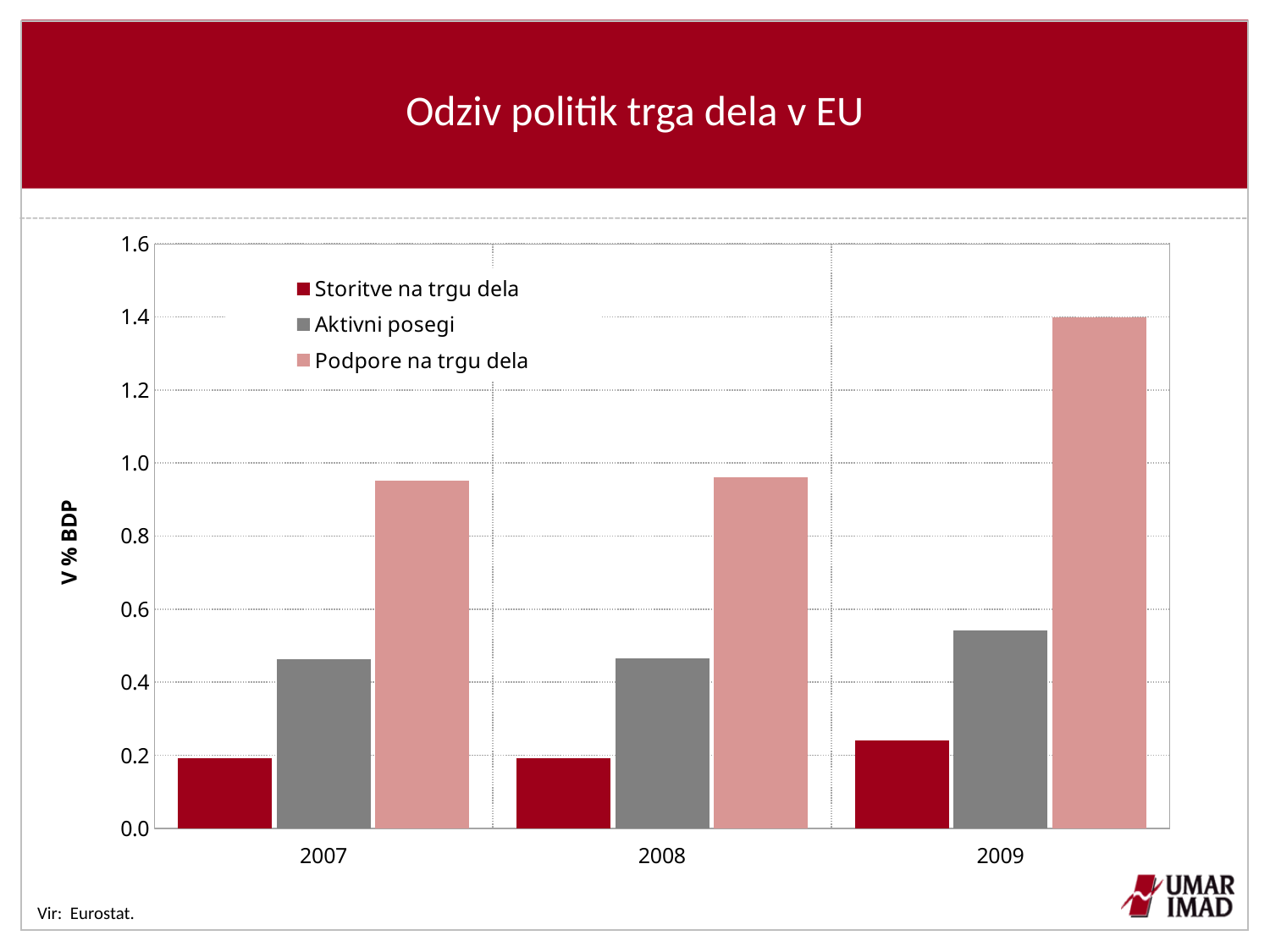
How many series does the legend list? 3 In which year is the value for Podpore na trgu dela the highest? 2009 What is the label of the y axis? V % BDP How many years are shown on the x axis? 3 What kind of chart is shown on the slide? bar chart Which series has the highest value in 2009? Podpore na trgu dela Is the value for Podpore na trgu dela in 2007 greater or less than 1.0? less Which series has the lowest value in 2007? Storitve na trgu dela Is the value for Aktivni posegi in 2009 greater or less than 0.6? less Which is larger: Aktivni posegi in 2009 or Aktivni posegi in 2008? Aktivni posegi in 2009 Is the value for Podpore na trgu dela in 2009 greater or less than 1.2? greater